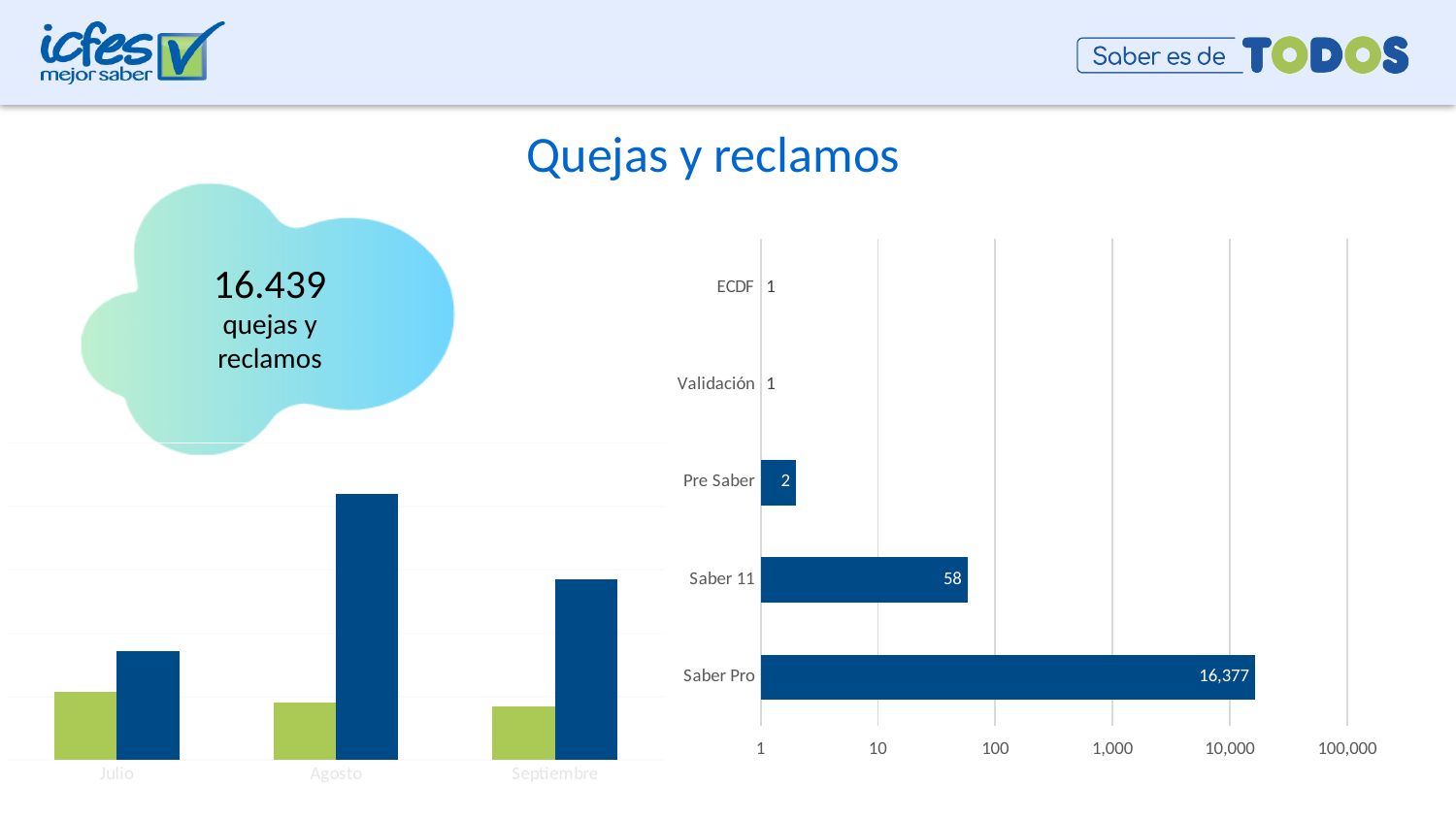
What kind of chart is shown on the right of the slide? Bar chart In the bar chart on the right, what is the difference between the values for Saber 11 and Pre Saber? 56 In the bar chart on the left, how many months are shown on the x axis? 3 In the bar chart on the right, how many categories are shown? 5 In the bar chart on the right, what is the value for Pre Saber? 2 In the bar chart on the right, which category has the highest value? Saber Pro In the bar chart on the right, what is the value for ECDF? 1 In the bar chart on the left, is the dark blue bar for Agosto taller or shorter than the dark blue bar for Septiembre? Taller In the bar chart on the right, what is the value for Saber Pro? 16,377 In the bar chart on the right, what is the difference between the values for Saber Pro and Saber 11? 16,319 In the bar chart on the right, what is the value for Saber 11? 58 In the bar chart on the right, is the value for Saber 11 larger than the value for Pre Saber? Yes